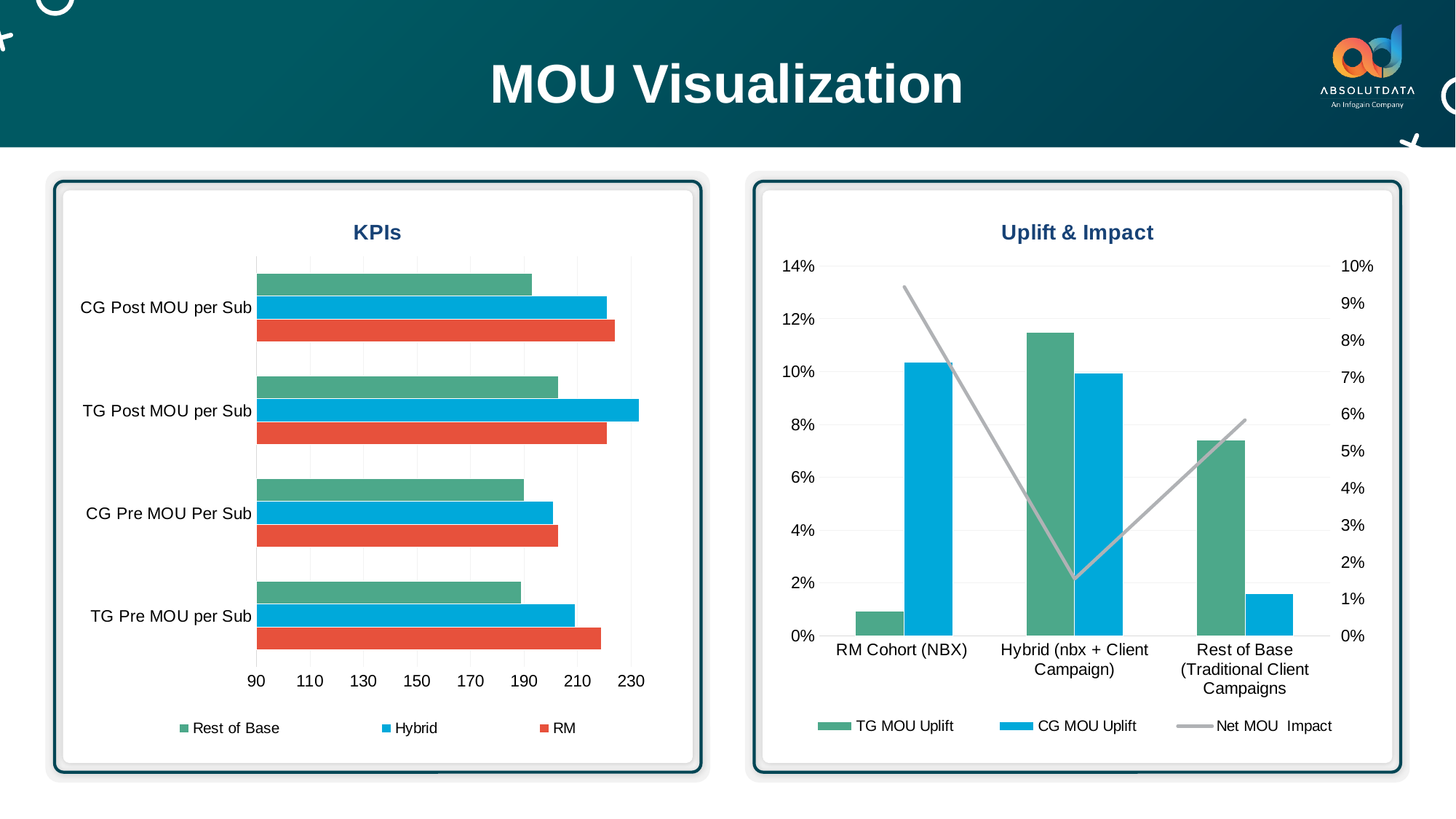
How many categories are shown on the x axis of the Uplift & Impact chart? 3 How many entries does the legend of the Uplift & Impact chart list? 3 What kind of chart is the KPIs chart? bar chart In the KPIs chart, for TG Post MOU per Sub, which is larger: Hybrid or Rest of Base? Hybrid In the KPIs chart, which series has the longest bar for TG Post MOU per Sub? Hybrid In the Uplift & Impact chart, is the TG MOU Uplift for Hybrid (nbx + Client Campaign) greater or less than 10%? greater In the Uplift & Impact chart, which series is drawn as a line rather than bars? Net MOU Impact How many series does the legend of the KPIs chart list? 3 In the KPIs chart, is the Rest of Base value for TG Pre MOU per Sub greater or less than 210? less In the Uplift & Impact chart, which category has the highest TG MOU Uplift? Hybrid (nbx + Client Campaign) How many categories does the KPIs chart show? 4 In the KPIs chart, is the RM value for CG Post MOU per Sub greater or less than 210? greater